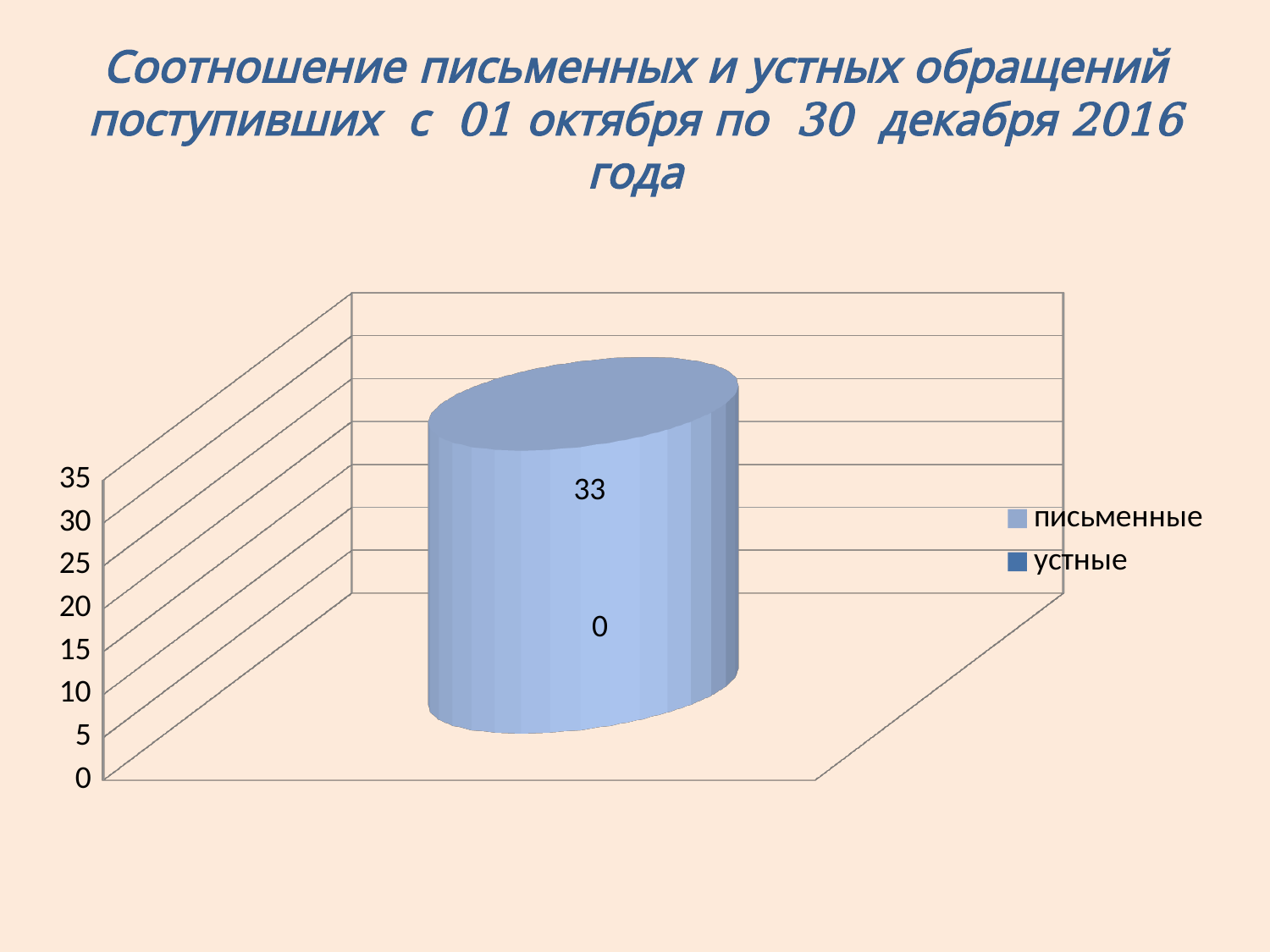
Which series has the lowest value? устные What is the second entry listed in the legend? устные Is the value for письменные greater or less than 30? greater What is the value for письменные? 33 What is the difference between the values for письменные and устные? 33 Which series has the higher value, письменные or устные? письменные Which series has the highest value? письменные What is the highest value shown on the vertical axis? 35 How many series does the legend list? 2 What is the value for устные? 0 What kind of chart is shown on the slide? bar chart What is the total of the values for письменные and устные? 33